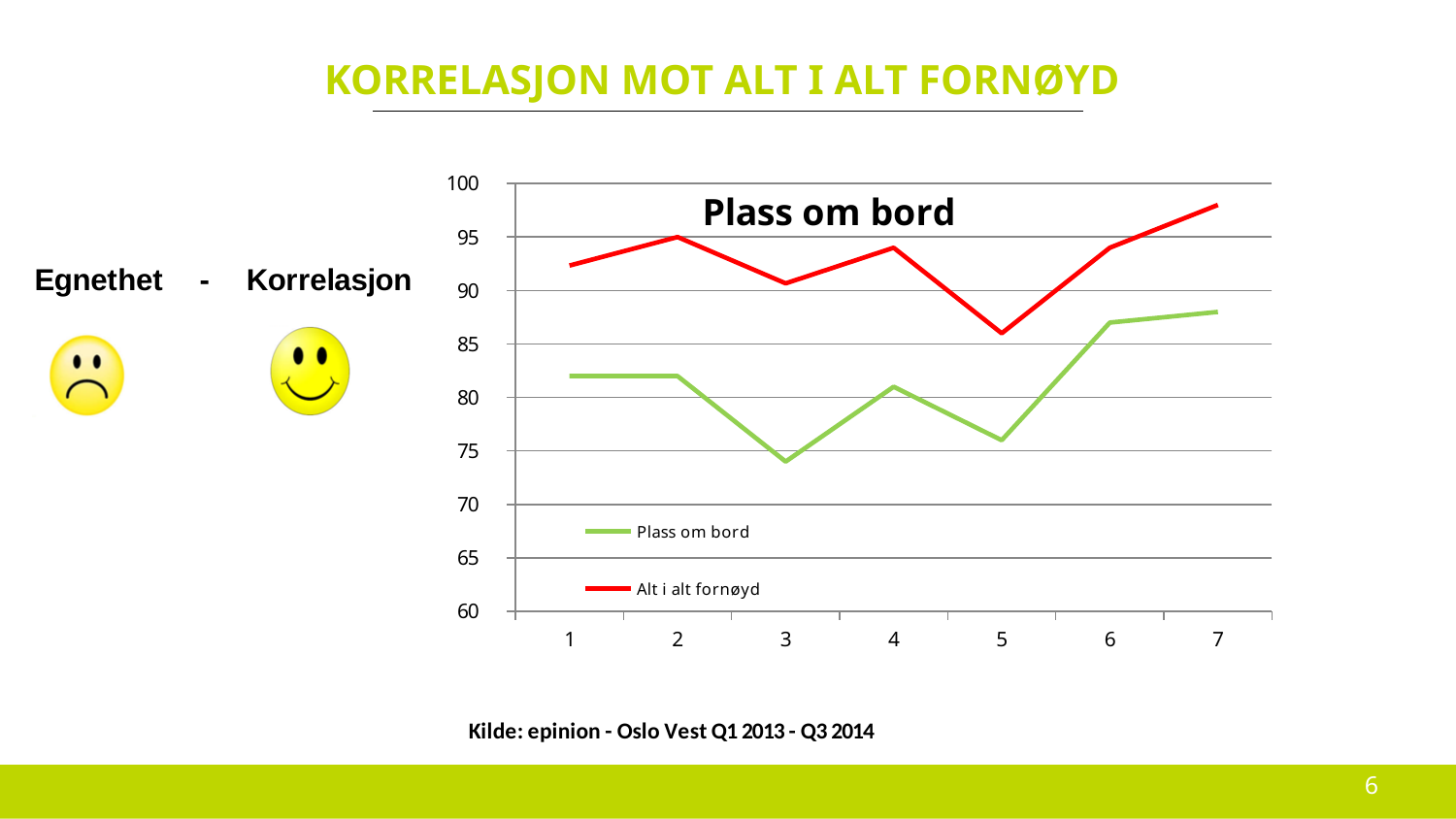
What kind of chart is shown on the slide? line chart At which x-axis point is the 'Alt i alt fornøyd' series lowest? 5 What is the title of the chart? Plass om bord How many points are plotted along the x axis for each series? 7 Is the value of 'Alt i alt fornøyd' at point 5 greater or less than 90? less How many series does the legend list? 2 At point 4, which series has the higher value, 'Plass om bord' or 'Alt i alt fornøyd'? Alt i alt fornøyd Does the 'Plass om bord' series rise or fall from point 5 to point 7? rise At which x-axis point is the 'Alt i alt fornøyd' series highest? 7 At which x-axis point is the 'Plass om bord' series lowest? 3 Which series is drawn with the red line? Alt i alt fornøyd Is the value of 'Plass om bord' at point 6 greater or less than 85? greater